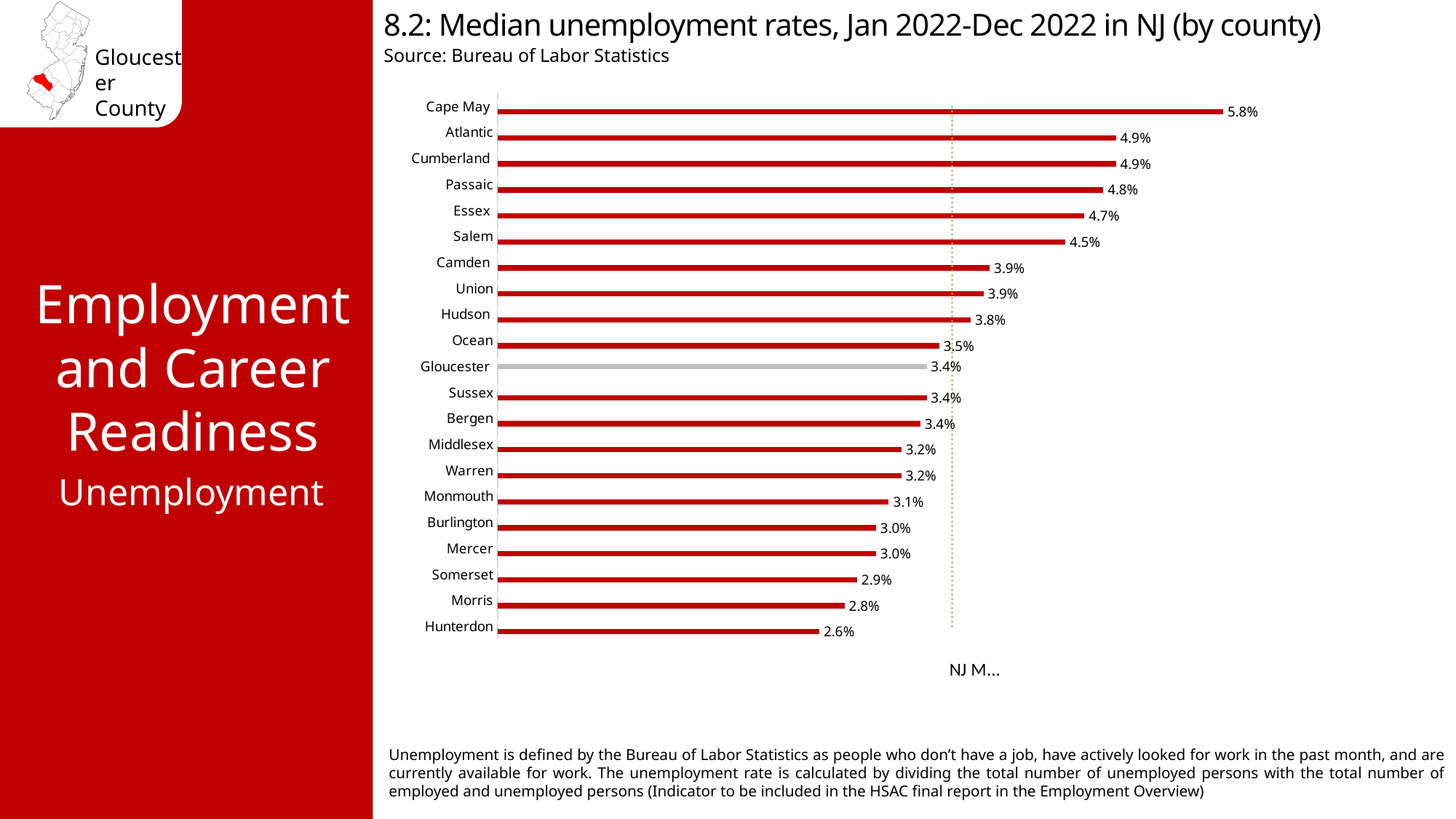
Which has a higher median unemployment rate, Essex or Camden? Essex What is the median unemployment rate for Salem? 4.5% What is the difference between the median unemployment rates of Cape May and Hunterdon? 3.2% How many counties are shown in the chart? 21 What is the median unemployment rate for Hunterdon? 2.6% Which county has the highest median unemployment rate? Cape May What is the median unemployment rate for Cape May? 5.8% Which county's bar is shown in grey rather than red? Gloucester What is the difference between the median unemployment rates of Passaic and Gloucester? 1.4% What type of chart is used to show the median unemployment rates? Bar chart What is the median unemployment rate for Gloucester County? 3.4% Which county has the lowest median unemployment rate? Hunterdon